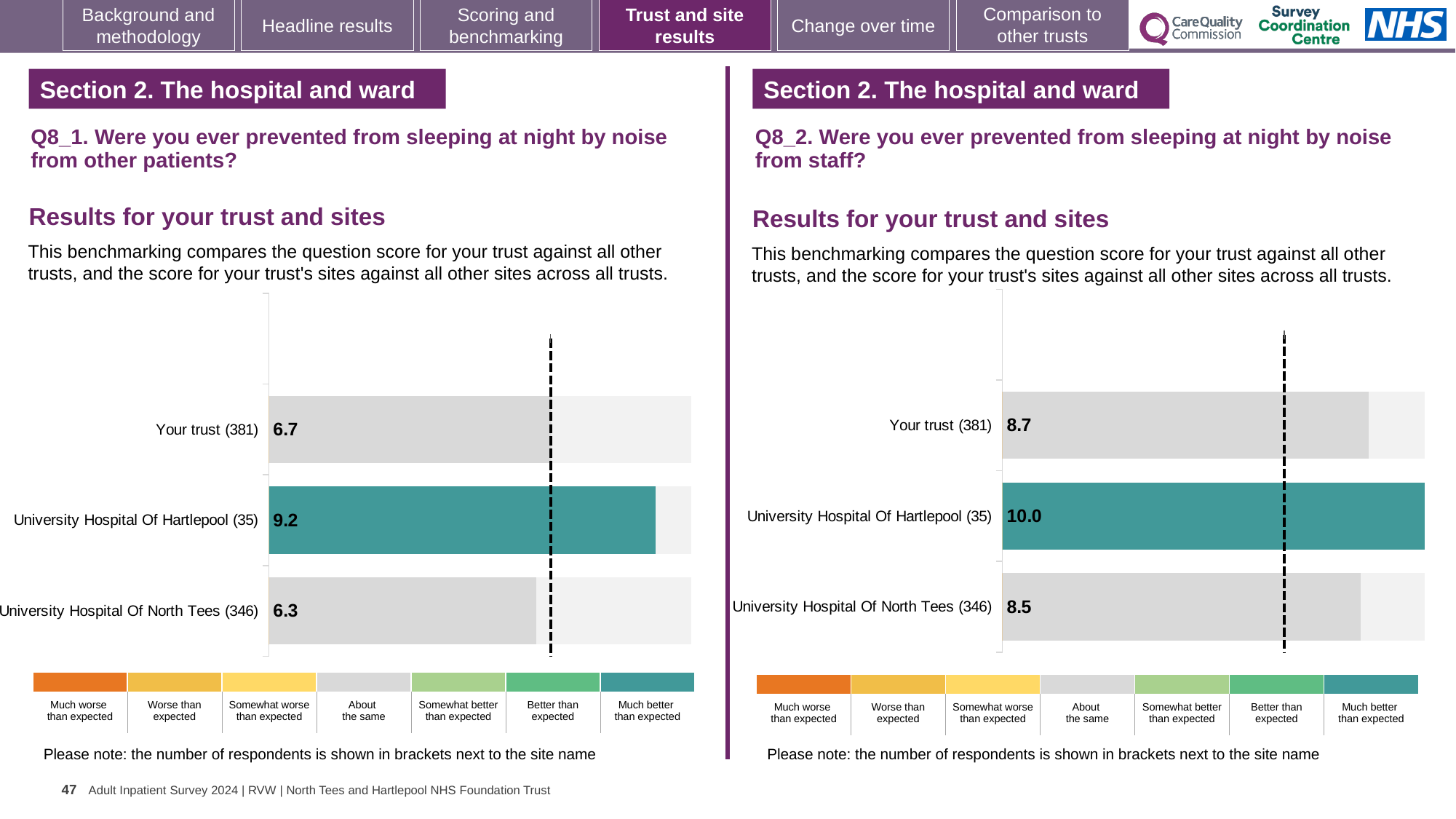
In the Q8_1 chart (left), what is the difference between the scores for University Hospital Of Hartlepool (35) and University Hospital Of North Tees (346)? 2.9 In the Q8_1 chart (left), what is the score for Your trust (381)? 6.7 In the Q8_2 chart (right), what is the score for University Hospital Of Hartlepool (35)? 10.0 In the Q8_2 chart (right), what is the difference between the scores for Your trust (381) and University Hospital Of North Tees (346)? 0.2 What kind of chart is the Q8_1 chart (left)? Bar chart In the Q8_1 chart (left), which site or trust has the lowest score? University Hospital Of North Tees (346) In the Q8_2 chart (right), what is the score for University Hospital Of North Tees (346)? 8.5 How many bars are plotted in the Q8_2 chart (right)? 3 In the Q8_1 chart (left), which benchmark category does the bar for University Hospital Of Hartlepool (35) fall into, according to its colour? Much better than expected In the Q8_1 chart (left), which has the larger score: Your trust (381) or University Hospital Of North Tees (346)? Your trust (381) In the Q8_1 chart (left), what is the score for University Hospital Of Hartlepool (35)? 9.2 In the Q8_2 chart (right), which site or trust has the highest score? University Hospital Of Hartlepool (35)